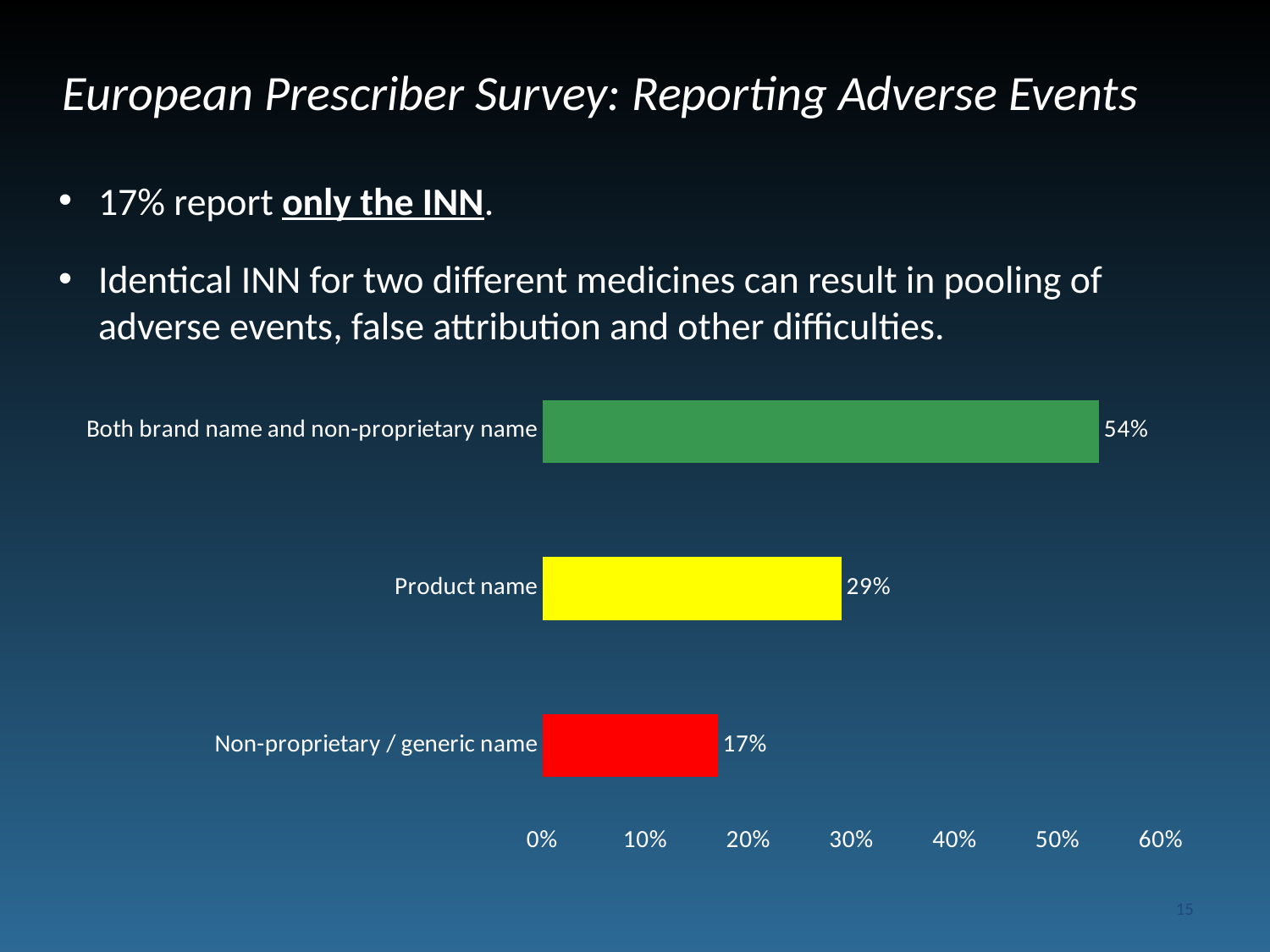
Is the value for 'Both brand name and non-proprietary name' greater or less than 50%? greater What percentage is shown for 'Non-proprietary / generic name'? 17% What is the difference between the values for 'Product name' and 'Non-proprietary / generic name'? 12% What kind of chart is shown on the slide? Bar chart Which category has the highest value? Both brand name and non-proprietary name Which category has the lowest value? Non-proprietary / generic name What is the difference between the values for 'Both brand name and non-proprietary name' and 'Product name'? 25% What percentage is shown for 'Both brand name and non-proprietary name'? 54% What percentage is shown for 'Product name'? 29% What colour is the bar for 'Product name'? Yellow How many categories are shown in the chart? 3 Which is larger, the value for 'Product name' or the value for 'Non-proprietary / generic name'? Product name